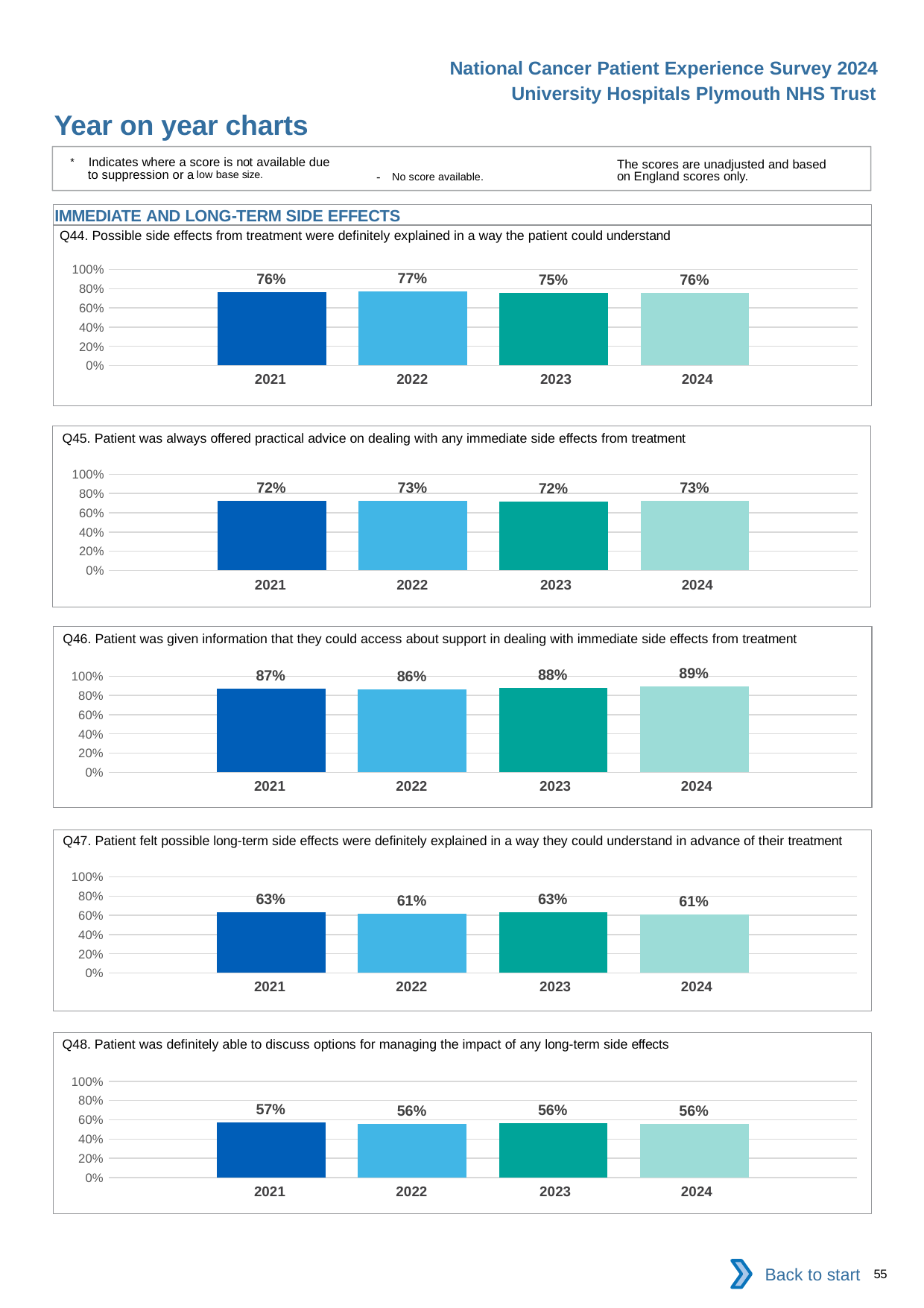
In the Q45 chart, what is the value for 2024? 73% In the Q46 chart, what is the value for 2021? 87% In the Q47 chart, is the value for 2024 greater or less than 80%? less In the Q47 chart, which is larger, the value for 2021 or the value for 2022? 2021 In the Q44 chart, what is the value for 2022? 77% In the Q48 chart, what is the value for 2021? 57% In the Q45 chart, what is the difference between the 2022 and 2021 values? 1% In the Q46 chart, which year has the highest value? 2024 What kind of chart is the Q44 chart? bar chart How many years are shown in the Q48 chart? 4 In the Q46 chart, what is the difference between the 2024 and 2022 values? 3% In the Q44 chart, which year has the lowest value? 2023